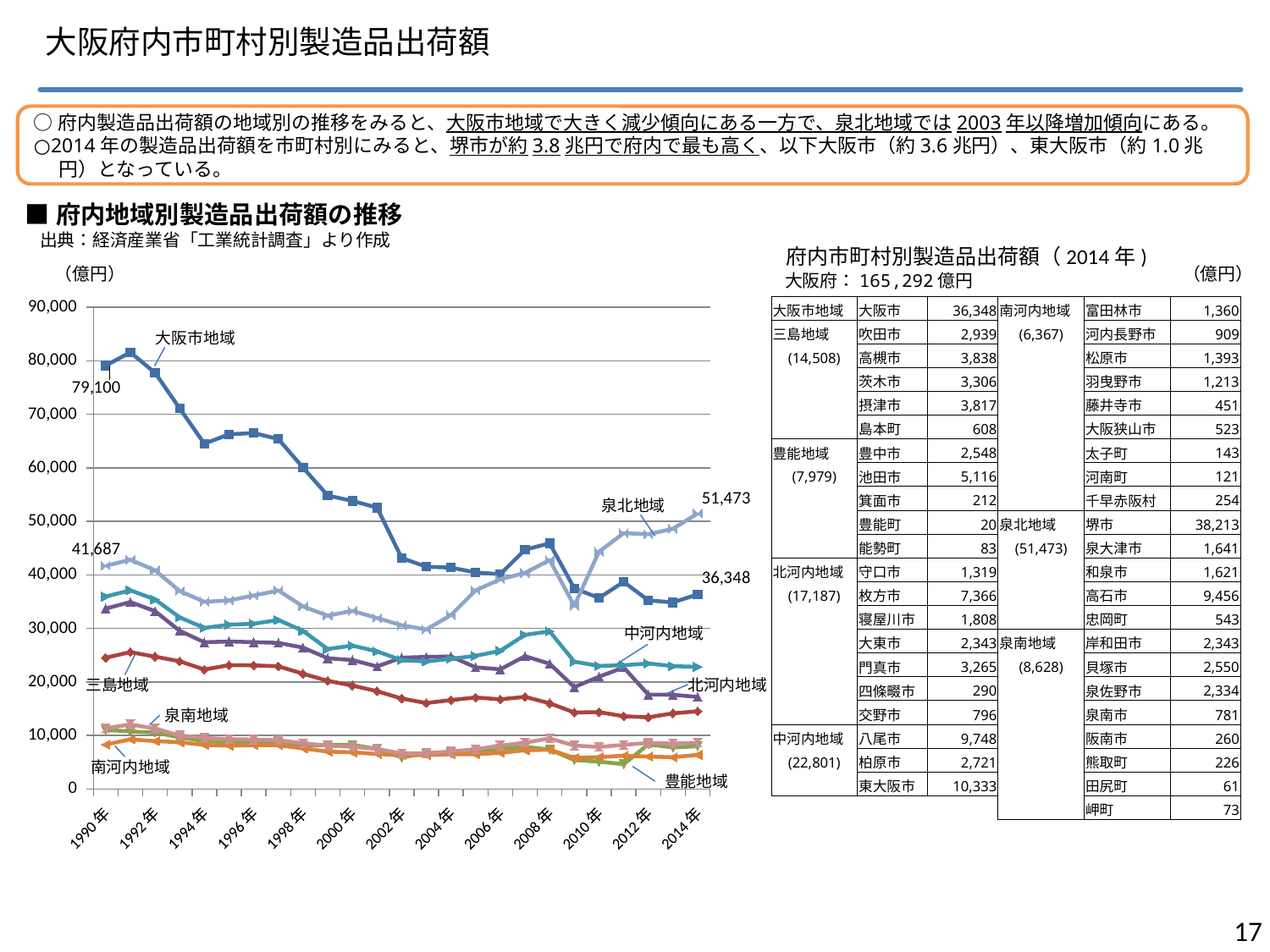
In 2014年, which is larger, 泉北地域 or 大阪市地域? 泉北地域 What is the value for 大阪市地域 in 2014年? 36,348 What is the value for 泉北地域 in 2014年? 51,473 By how much did the value for 大阪市地域 fall from 1990年 to 2014年? 42,752 What is the value for 泉北地域 in 1990年? 41,687 Does the value for 大阪市地域 rise or fall from 1990年 to 2014年? fall What kind of chart is shown on the slide? line chart By how much did the value for 泉北地域 rise from 1990年 to 2014年? 9,786 What is the difference between 泉北地域 and 大阪市地域 in 2014年? 15,125 Is the value for 三島地域 in 1990年 greater or less than 30,000? less Which region has the highest value in 1990年? 大阪市地域 What is the value for 大阪市地域 in 1990年? 79,100